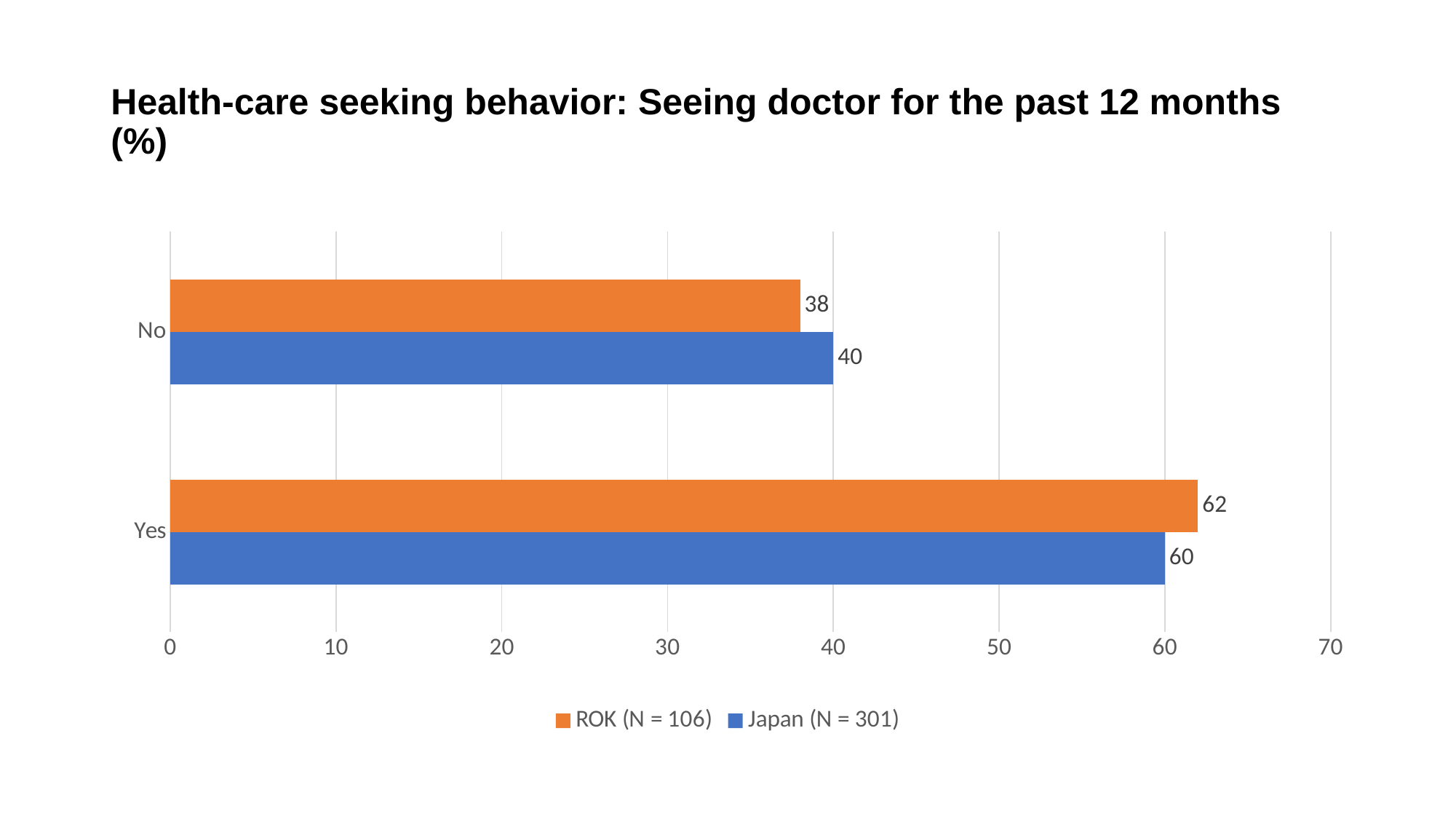
What kind of chart is shown on the slide? Bar chart Which category has the lowest value for Japan (N = 301)? No What is the value for ROK (N = 106) in the No category? 38 Which is larger in the No category: ROK (N = 106) or Japan (N = 301)? Japan (N = 301) How many categories are shown on the chart? 2 What is the difference between the Yes and No values for ROK (N = 106)? 24 Which category has the highest value for ROK (N = 106)? Yes What is the value for ROK (N = 106) in the Yes category? 62 What is the value for Japan (N = 301) in the No category? 40 What is the value for Japan (N = 301) in the Yes category? 60 How many series does the legend list? 2 What is the difference between the ROK (N = 106) and Japan (N = 301) values in the Yes category? 2